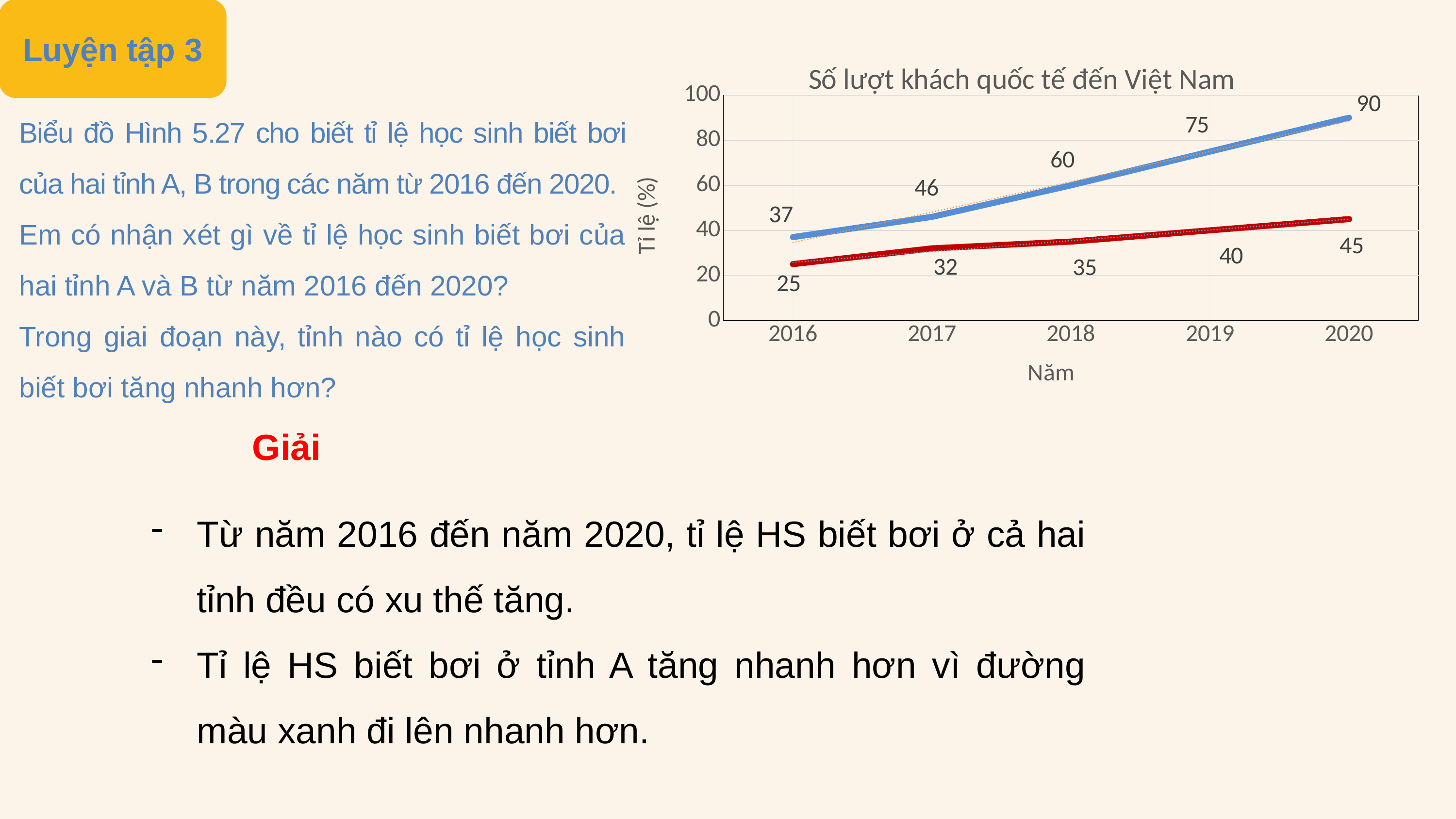
In which year does the red line have its lowest value? 2016 In which year does the blue line reach its highest value? 2020 What is the value of the blue line in 2018? 60 Do the values of the red line rise or fall from 2016 to 2020? rise How many years are shown on the x axis of the chart? 5 What is the title of the chart? Số lượt khách quốc tế đến Việt Nam What is the value of the red line in 2019? 40 What is the label of the vertical axis of the chart? Tỉ lệ (%) What kind of chart is shown on the slide? line chart Which line has the larger value in 2017, the blue line or the red line? blue line What is the value of the blue line in 2016? 37 What is the difference between the blue line and the red line in 2020? 45